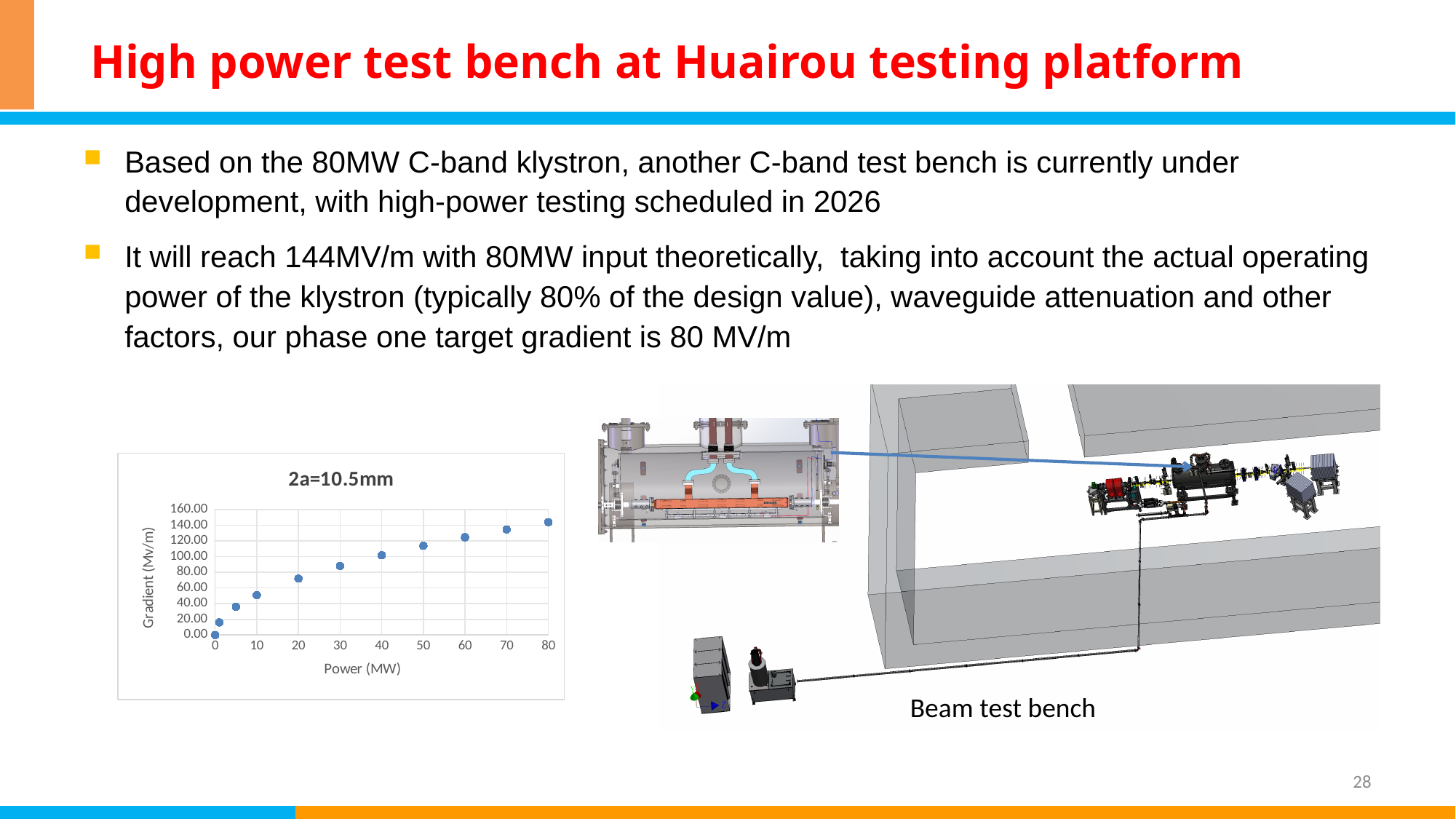
Is the gradient at 80 MW greater or less than 120? greater What kind of chart is shown on the slide? Scatter chart At which power value is the gradient highest? 80 MW What is the label of the x axis of the chart? Power (MW) Is the gradient at 40 MW greater or less than 80? greater At which power value is the gradient lowest? 0 MW Which has the larger gradient, 20 MW or 60 MW? 60 MW Is the gradient at 30 MW greater or less than 100? less What is the title of the chart? 2a=10.5mm How many data points are plotted in the chart? 11 Does the gradient rise or fall as power increases along the x axis? Rises